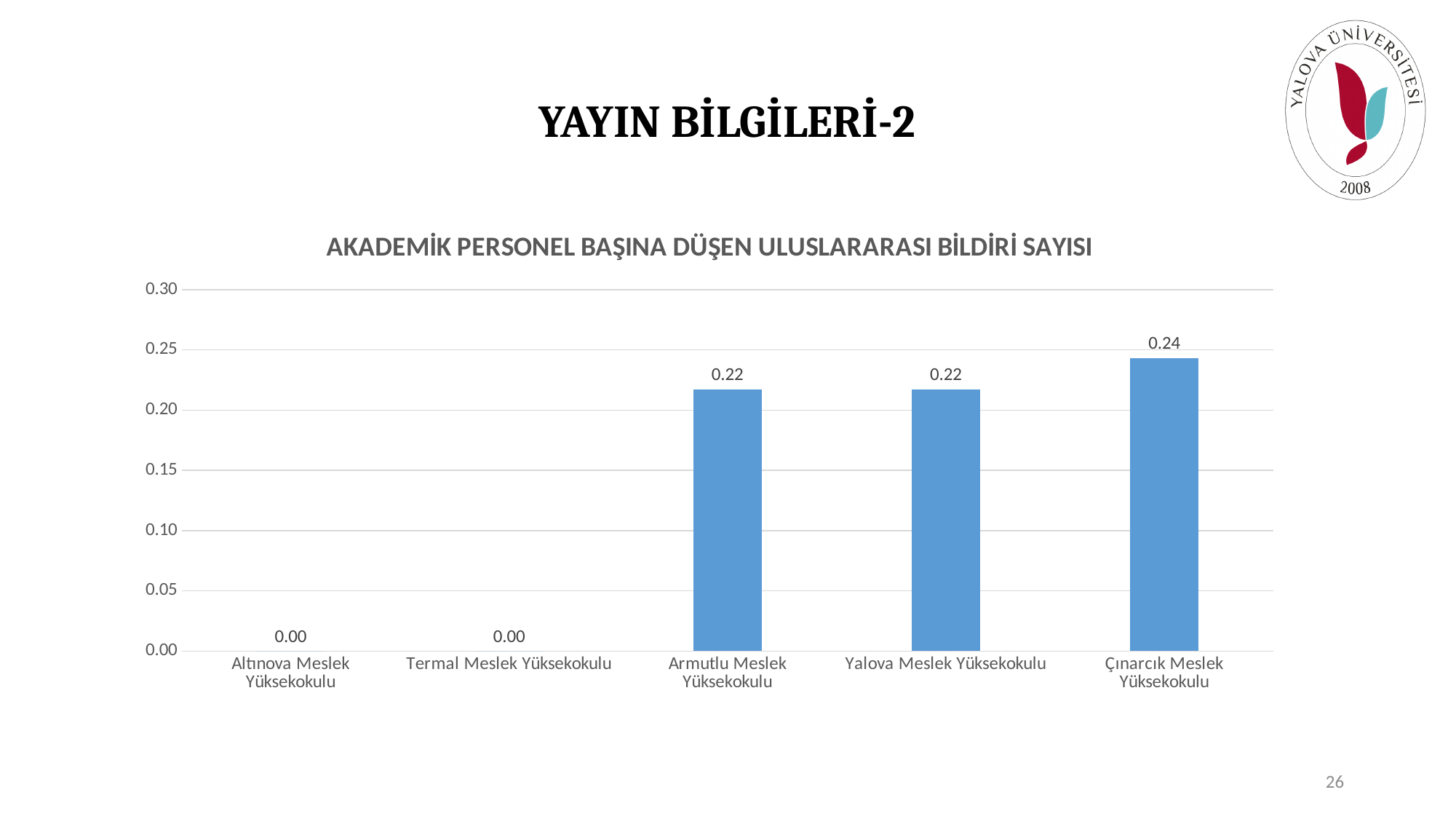
Which category has the highest value? Çınarcık Meslek Yüksekokulu What is the value for Altınova Meslek Yüksekokulu? 0.00 Is the value for Armutlu Meslek Yüksekokulu greater or less than 0.20? greater What is the value for Yalova Meslek Yüksekokulu? 0.22 Which is larger, the value for Çınarcık Meslek Yüksekokulu or the value for Yalova Meslek Yüksekokulu? Çınarcık Meslek Yüksekokulu How many categories have a value of 0.00? 2 What is the value for Armutlu Meslek Yüksekokulu? 0.22 What is the difference between the values for Çınarcık Meslek Yüksekokulu and Armutlu Meslek Yüksekokulu? 0.02 How many categories are shown on the x axis? 5 What is the title of the chart? AKADEMİK PERSONEL BAŞINA DÜŞEN ULUSLARARASI BİLDİRİ SAYISI What is the value for Çınarcık Meslek Yüksekokulu? 0.24 What kind of chart is shown on the slide? bar chart